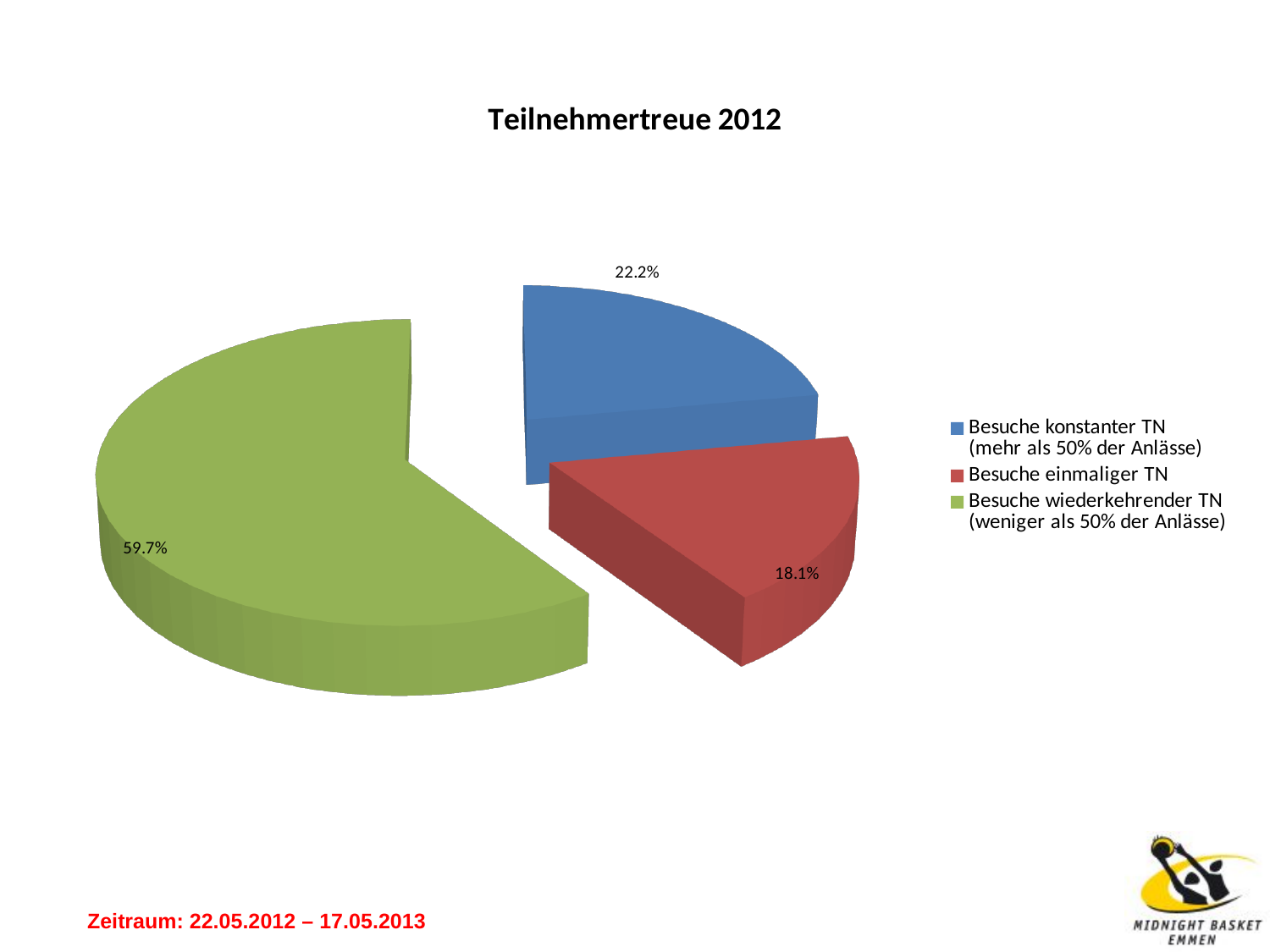
How many slices does the pie chart have? 3 What kind of chart is shown on the slide? pie chart What is the title of the chart? Teilnehmertreue 2012 Which is larger: the share for 'Besuche konstanter TN' or the share for 'Besuche einmaliger TN'? Besuche konstanter TN What colour is the slice for 'Besuche einmaliger TN'? red Which category has the smallest slice of the pie? Besuche einmaliger TN What is the difference in percentage points between 'Besuche konstanter TN' and 'Besuche einmaliger TN'? 4.1 What share of the pie is 'Besuche konstanter TN (mehr als 50% der Anlässe)'? 22.2% What share of the pie is 'Besuche wiederkehrender TN (weniger als 50% der Anlässe)'? 59.7% What share of the pie is 'Besuche einmaliger TN'? 18.1% Which category has the largest slice of the pie? Besuche wiederkehrender TN (weniger als 50% der Anlässe) How many entries does the legend list? 3